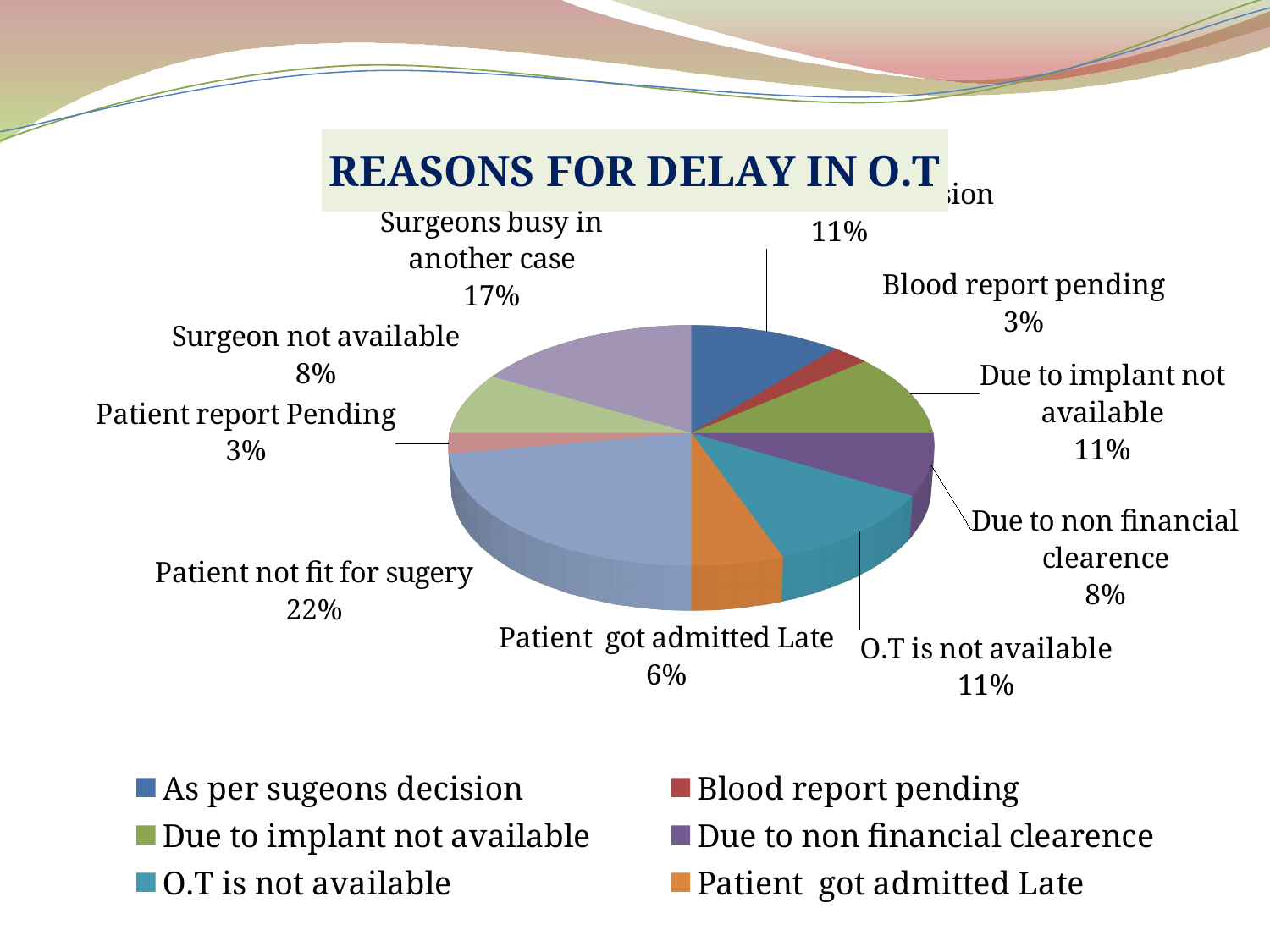
What is the value for 'Blood report pending'? 3% What is the value for 'Due to non financial clearence'? 8% What share of the pie is 'Surgeons busy in another case'? 17% What is the difference between 'Patient not fit for sugery' and 'Surgeons busy in another case'? 5% Which is larger: 'O.T is not available' or 'Patient got admitted Late'? O.T is not available What percentage is shown for 'Patient got admitted Late'? 6% How many slices does the pie chart have? 10 What type of chart is shown on the slide? pie chart What is the title of the chart? REASONS FOR DELAY IN O.T Which reason has the largest share of the pie? Patient not fit for sugery What percentage of delays is attributed to 'Patient not fit for sugery'? 22% What is the difference between 'Surgeon not available' and 'Patient report Pending'? 5%